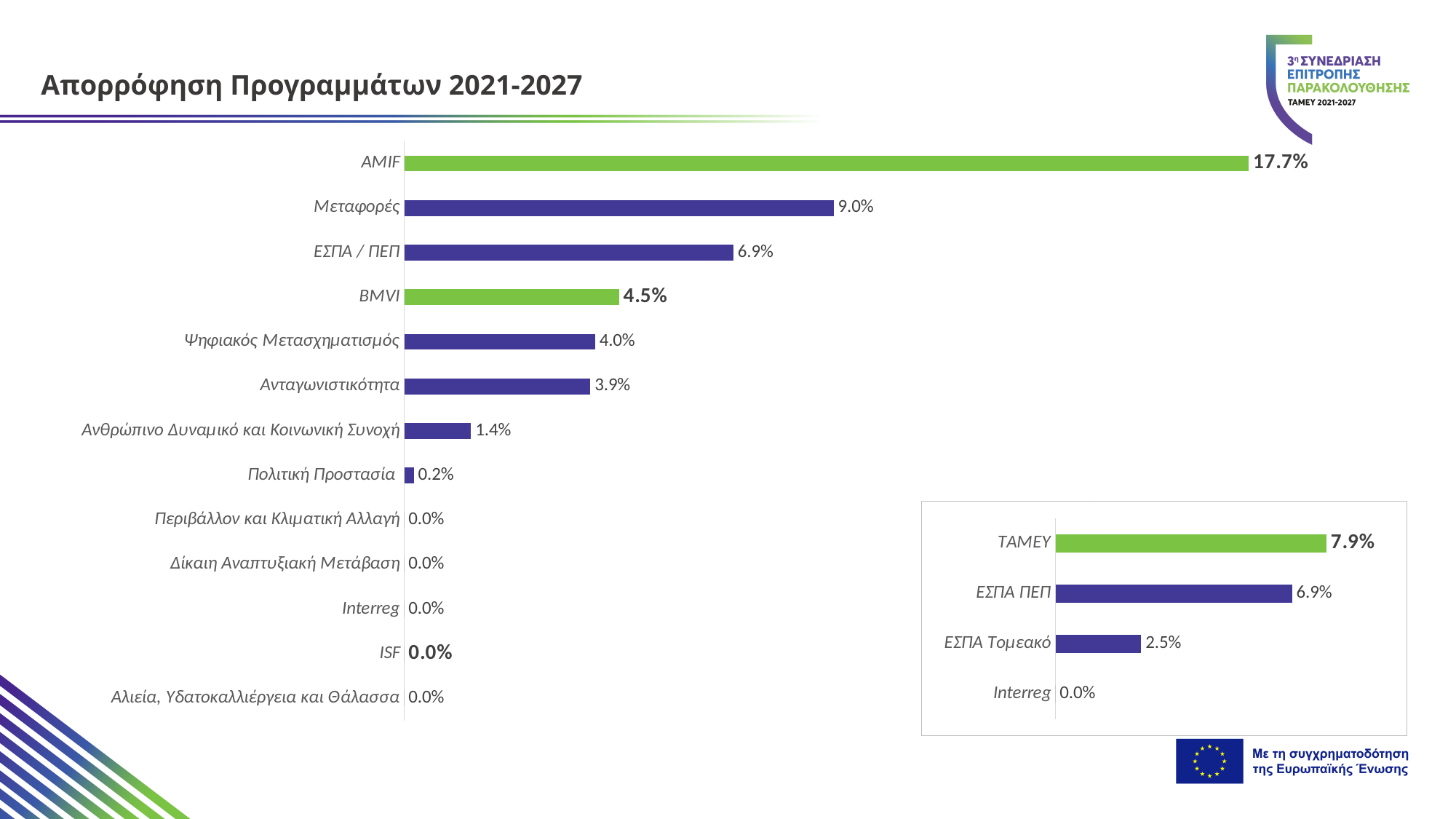
In the large chart on the left, what is the value for BMVI? 4.5% In the large chart on the left, what is the value for Μεταφορές? 9.0% In the large chart on the left, what is the value for AMIF? 17.7% In the small chart on the right, what is the difference between the values for ΕΣΠΑ ΠΕΠ and ΕΣΠΑ Τομεακό? 4.4% In the small chart on the right, what is the value for ΤΑΜΕΥ? 7.9% In the large chart on the left, which is larger, the value for Ψηφιακός Μετασχηματισμός or the value for Ανθρώπινο Δυναμικό και Κοινωνική Συνοχή? Ψηφιακός Μετασχηματισμός In the small chart on the right, which category has the lowest value? Interreg In the large chart on the left, what is the difference between the values for AMIF and Μεταφορές? 8.7% In the large chart on the left, which category has the highest value? AMIF What kind of chart is the large chart on the left? Bar chart How many categories are shown in the small chart on the right? 4 How many categories are shown in the large chart on the left? 13